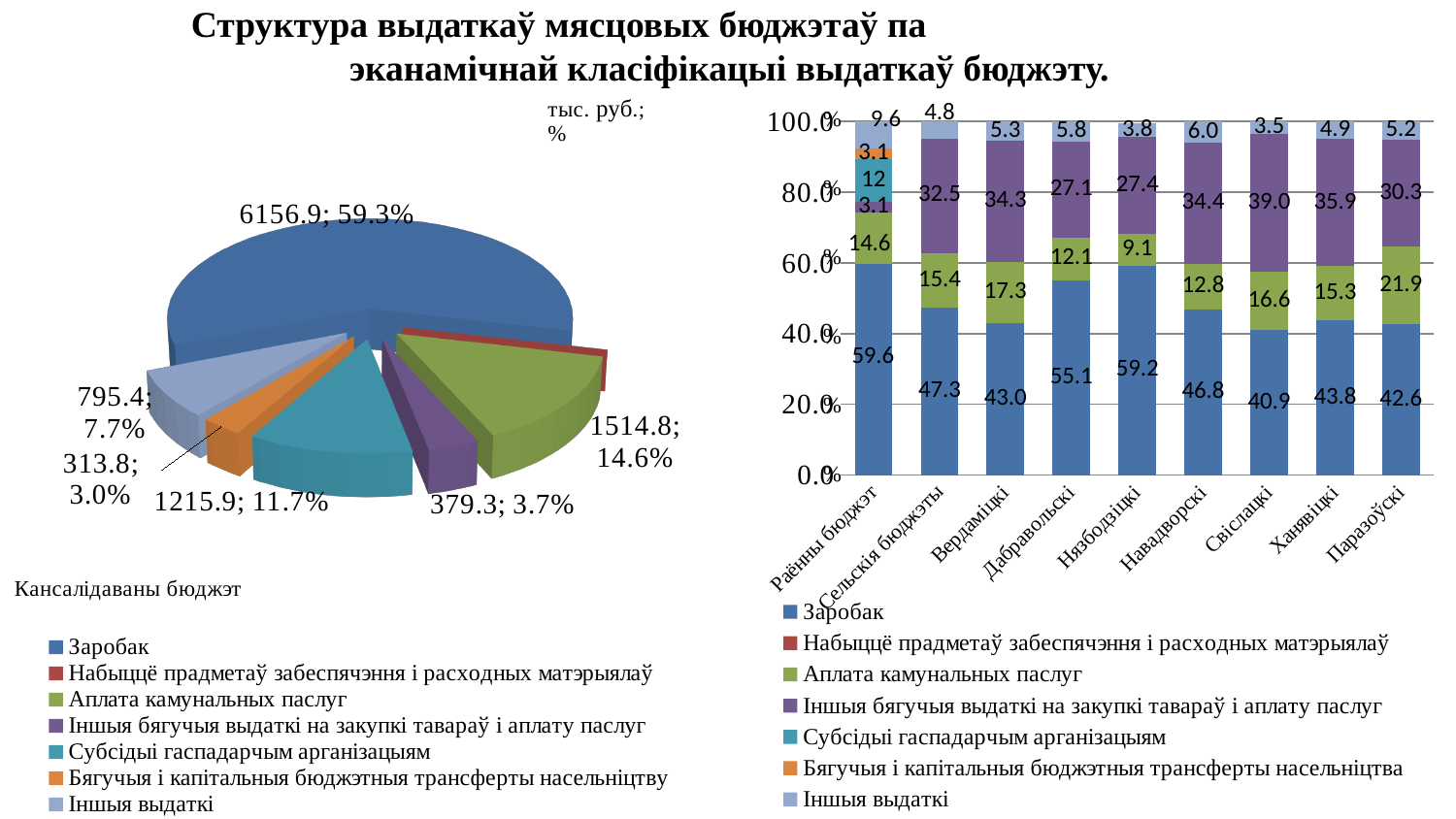
On the stacked bar chart, how many series does the legend list? 7 What kind of chart is the left chart (Кансалідаваны бюджэт)? Pie chart On the pie chart (Кансалідаваны бюджэт), what share does Субсідыі гаспадарчым арганізацыям have? 11.7% On the pie chart (Кансалідаваны бюджэт), what is the data label for the Заробак slice? 6156.9; 59.3% What kind of chart is the right chart with the budgets on the x axis? Stacked bar chart On the stacked bar chart, what is the difference between the Заробак values for Раённы бюджэт and Свіслацкі? 18.7 On the pie chart (Кансалідаваны бюджэт), what share does Аплата камунальных паслуг have? 14.6% On the stacked bar chart, which budget has the lowest Заробак value? Свіслацкі On the stacked bar chart, what is the Заробак value for Свіслацкі? 40.9 On the stacked bar chart, which budget has the highest Заробак value? Раённы бюджэт On the stacked bar chart, which has the larger Іншыя бягучыя выдаткі на закупкі тавараў і аплату паслуг value, Свіслацкі or Паразоўскі? Свіслацкі On the stacked bar chart, how many budgets are shown on the x axis? 9